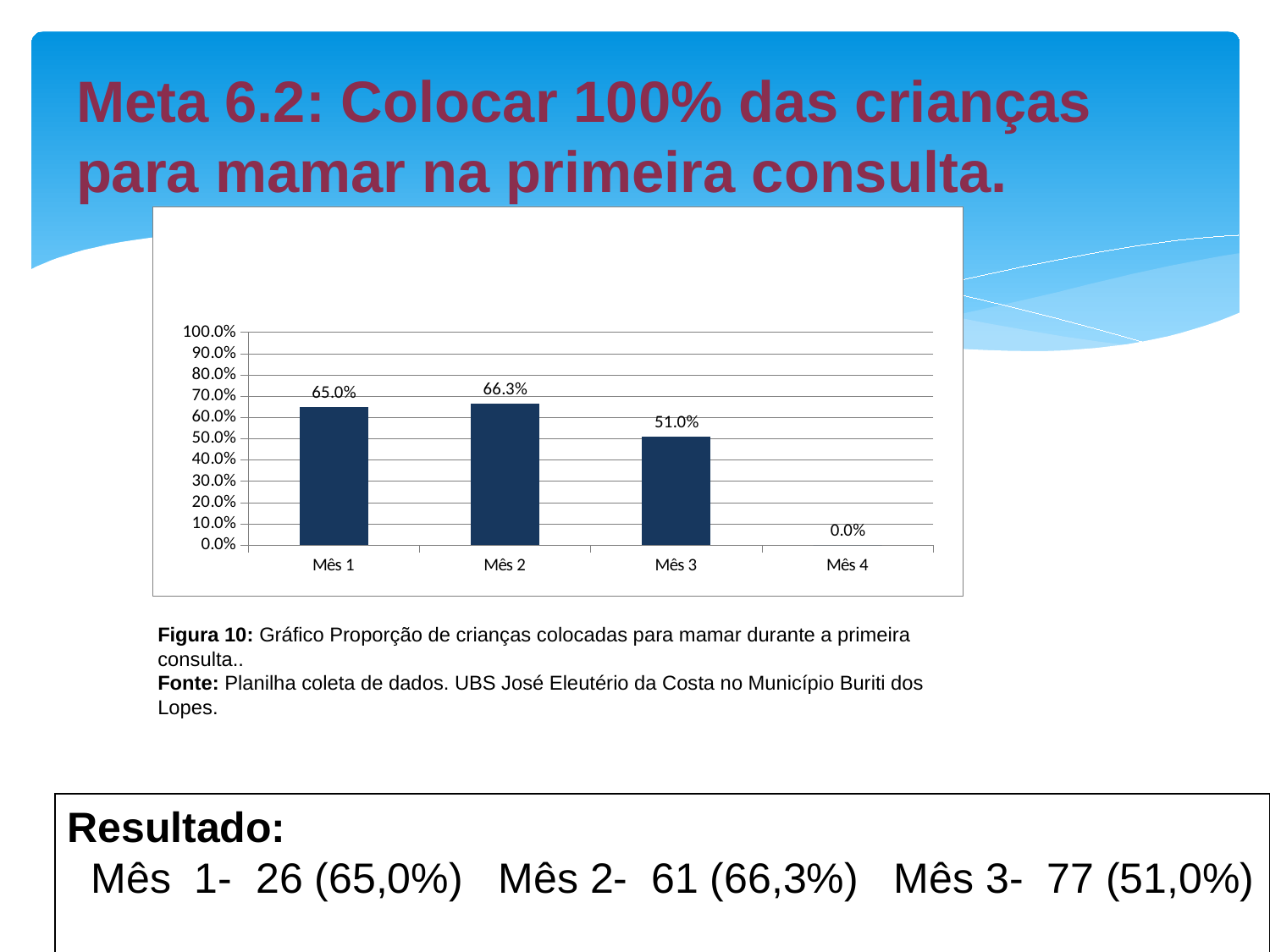
Which is larger, the value for Mês 1 or the value for Mês 3? Mês 1 What is the value for Mês 4? 0.0% What kind of chart is shown on the slide? bar chart What is the value for Mês 2? 66.3% Which month has the highest value? Mês 2 Do the values rise or fall from Mês 2 to Mês 4? fall What is the value for Mês 3? 51.0% What is the difference between the values for Mês 2 and Mês 3? 15.3% How many categories are shown on the x axis? 4 Is the value for Mês 3 greater or less than 60.0%? less Which month has the lowest value? Mês 4 What is the value for Mês 1? 65.0%